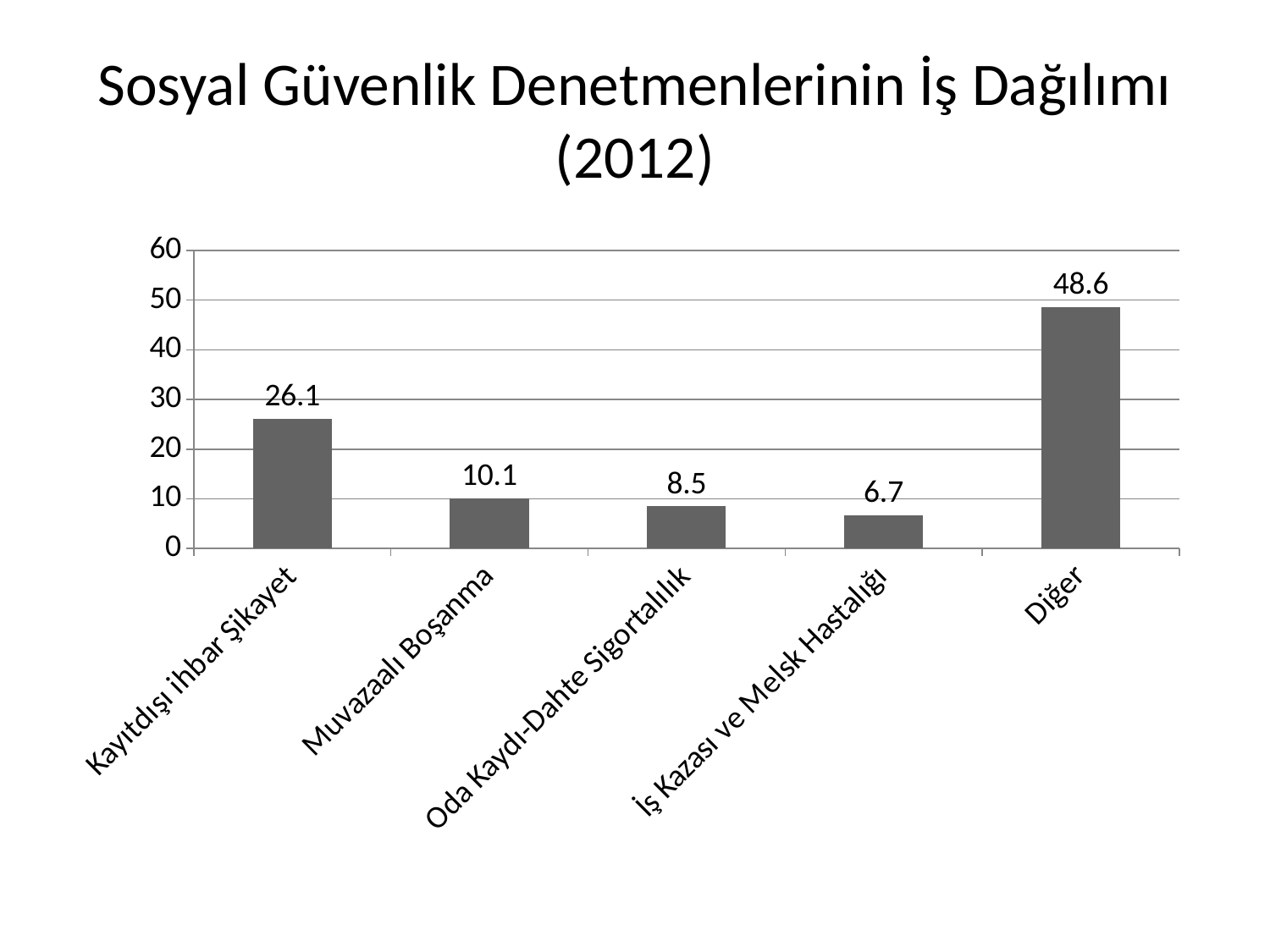
How many categories are shown in the chart? 5 What is the difference between the values for Diğer and Kayıtdışı ihbar Şikayet? 22.5 Which category has the highest value? Diğer What is the value for Diğer? 48.6 What is the value for İş Kazası ve Melsk Hastalığı? 6.7 What kind of chart is shown on the slide? bar chart What is the value for Oda Kaydı-Dahte Sigortalılık? 8.5 What is the value for Muvazaalı Boşanma? 10.1 Which is larger, the value for Muvazaalı Boşanma or the value for Oda Kaydı-Dahte Sigortalılık? Muvazaalı Boşanma What is the title of the slide? Sosyal Güvenlik Denetmenlerinin İş Dağılımı (2012) Which category has the lowest value? İş Kazası ve Melsk Hastalığı What is the value for Kayıtdışı ihbar Şikayet? 26.1